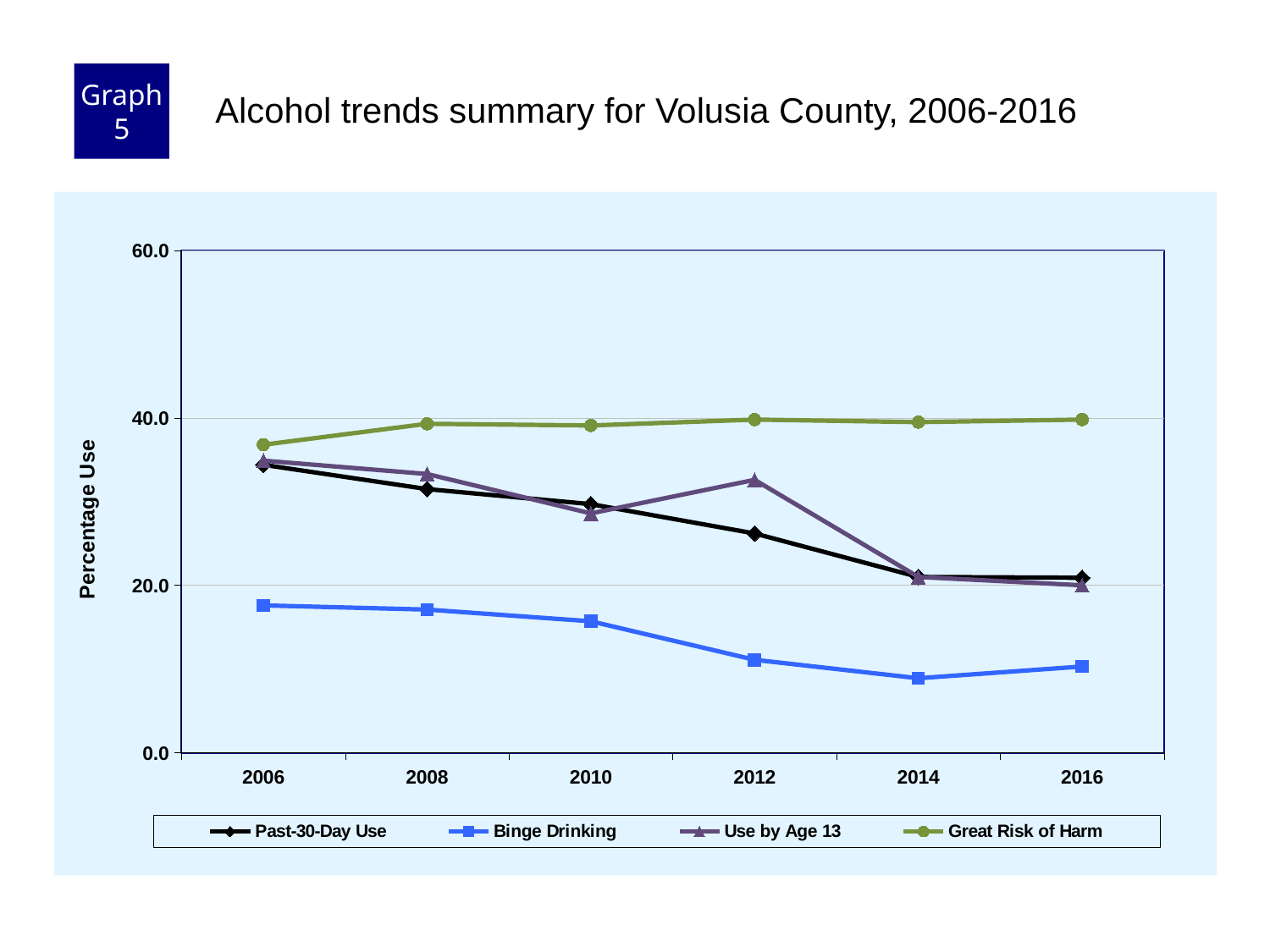
Is the value for Use by Age 13 in 2012 greater or less than 20.0? greater Does the Past-30-Day Use series rise or fall from 2006 to 2016? fall Which series has the lowest value in 2010? Binge Drinking What kind of chart is shown on the slide? line chart How many series does the legend list? 4 In 2012, which is larger: Great Risk of Harm or Binge Drinking? Great Risk of Harm Is the value for Great Risk of Harm in 2006 greater or less than 40.0? less Which series has the highest value in 2016? Great Risk of Harm What is the label on the y axis? Percentage Use How many years are plotted along the x axis? 6 Is the value for Binge Drinking in 2014 greater or less than 20.0? less What is the title of the chart? Alcohol trends summary for Volusia County, 2006-2016